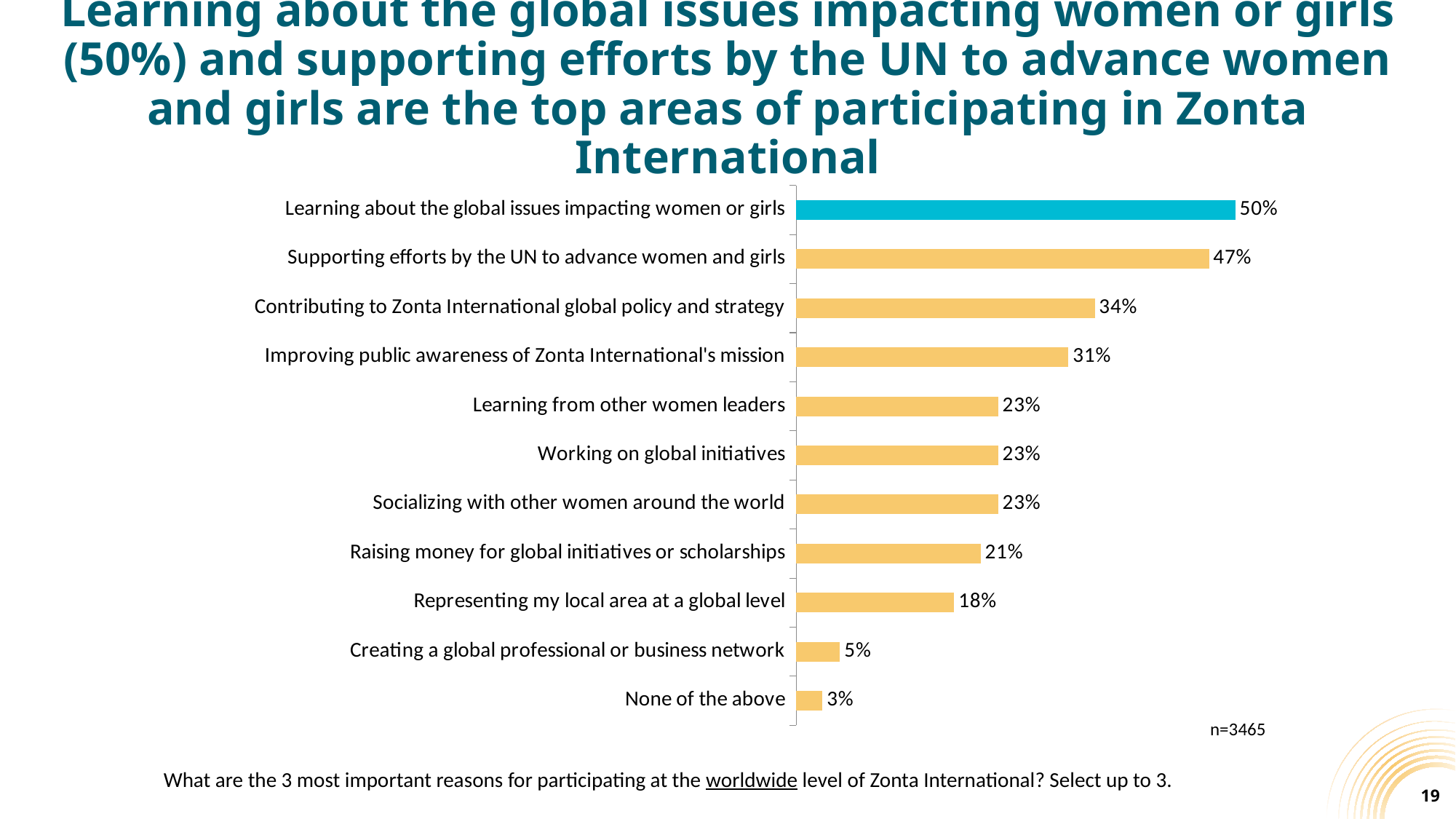
What is the value for 'Contributing to Zonta International global policy and strategy'? 34% How many categories are shown in the chart? 11 What percentage of respondents selected 'Learning about the global issues impacting women or girls'? 50% Which is larger: 'Raising money for global initiatives or scholarships' or 'Representing my local area at a global level'? Raising money for global initiatives or scholarships What percentage selected 'Representing my local area at a global level'? 18% Which category has the highest value? Learning about the global issues impacting women or girls What is the difference between 'Improving public awareness of Zonta International's mission' and 'Creating a global professional or business network'? 26% What kind of chart is shown on the slide? Bar chart What is the sample size (n) noted on the chart? n=3465 What is the value for 'None of the above'? 3% Which category has the lowest value? None of the above What is the difference between 'Learning about the global issues impacting women or girls' and 'Supporting efforts by the UN to advance women and girls'? 3%